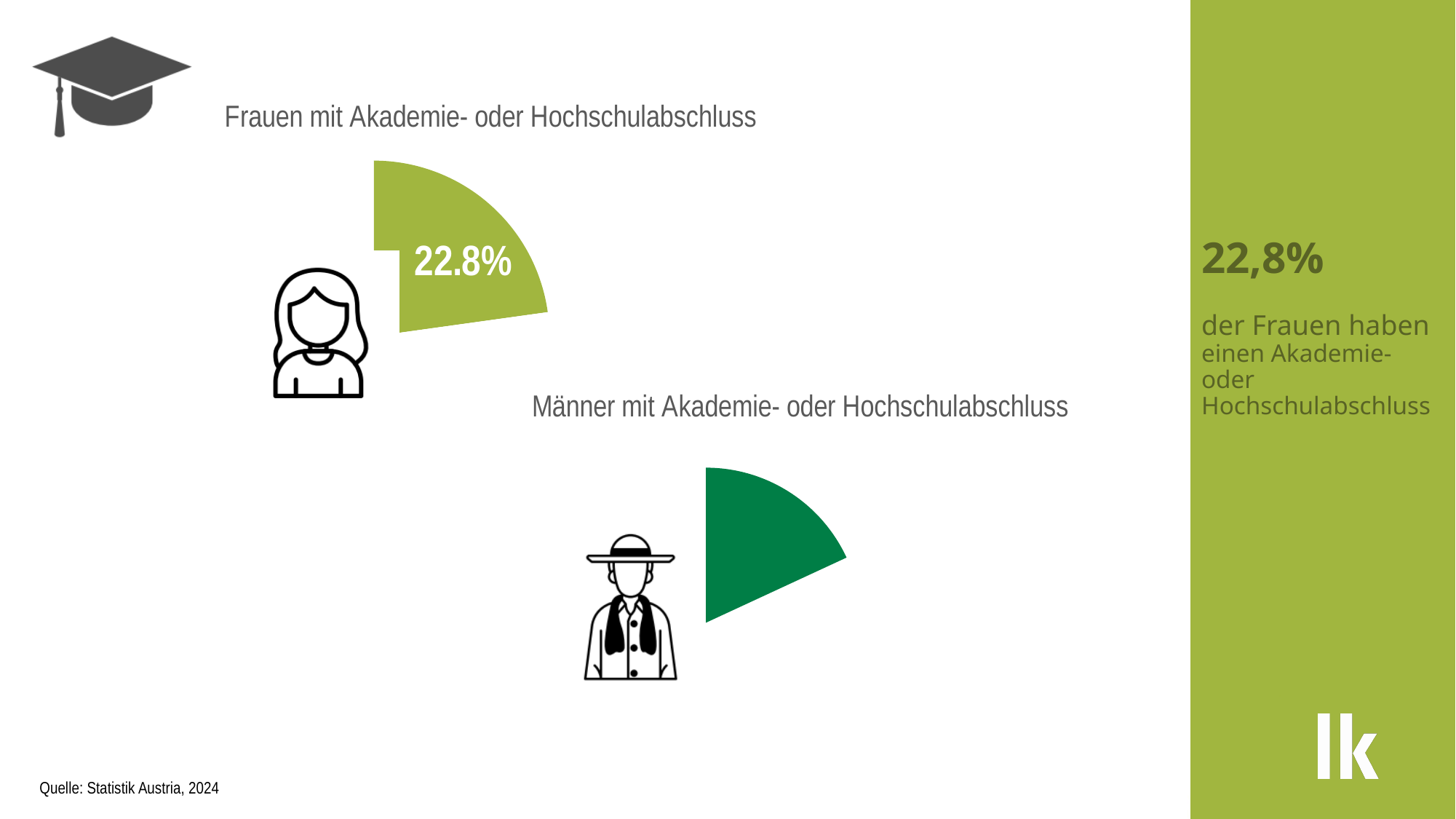
What kind of chart is used for "Frauen mit Akademie- oder Hochschulabschluss"? pie chart In the chart titled "Frauen mit Akademie- oder Hochschulabschluss", what percentage is shown on the slice? 22.8% How many charts are shown on the slide? 2 What kind of chart is used for "Männer mit Akademie- oder Hochschulabschluss"? pie chart Is the value for women with an academy or university degree greater or less than 20%? greater What is the title of the upper chart on the slide? Frauen mit Akademie- oder Hochschulabschluss What is the title of the lower chart on the slide? Männer mit Akademie- oder Hochschulabschluss